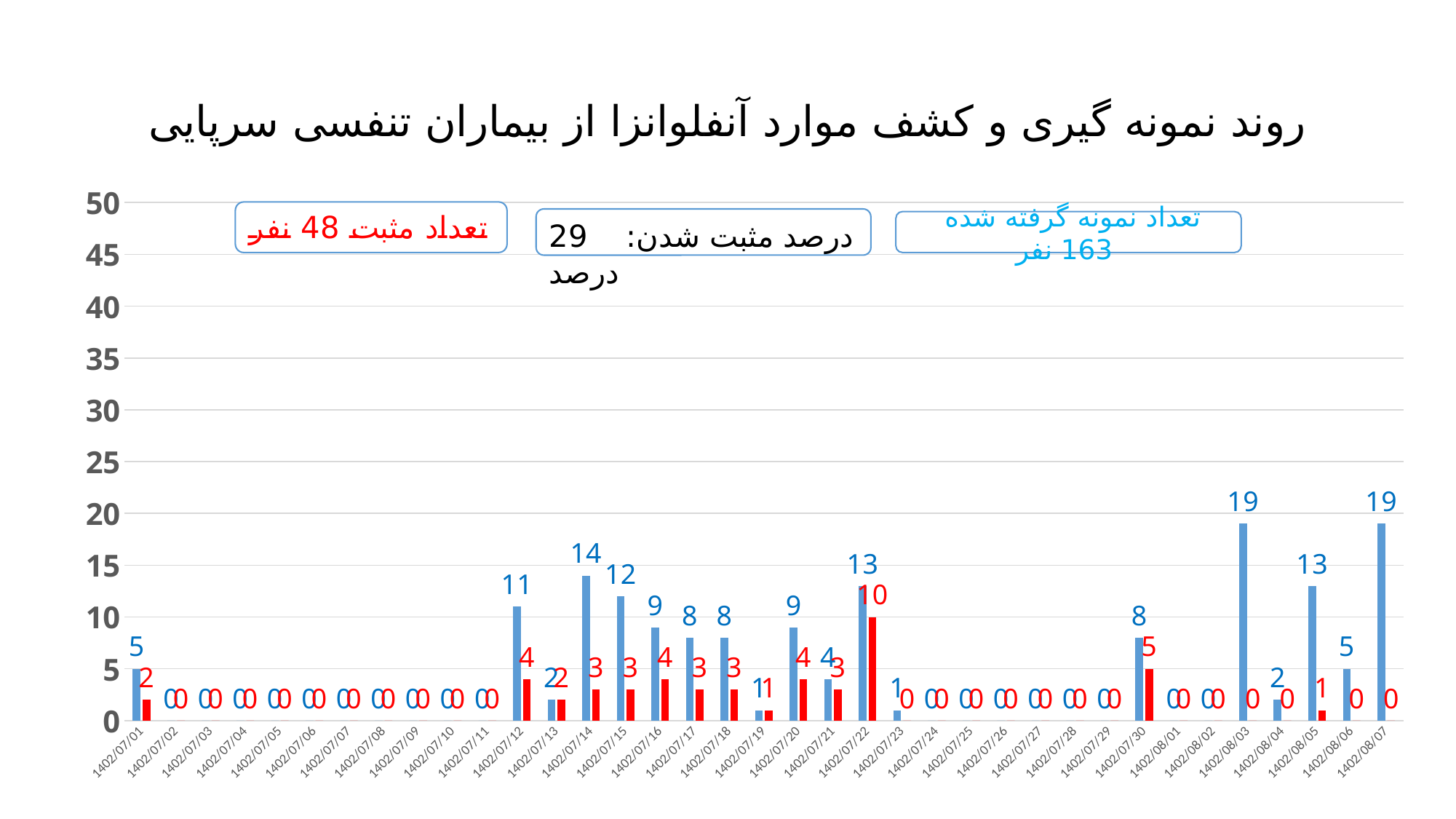
What is the value of the red bar for 1402/07/22? 10 Is the blue bar for 1402/08/03 greater or less than 15? greater What is the difference between the blue bar values for 1402/08/03 and 1402/08/05? 6 What is the value of the blue bar for 1402/07/12? 11 On which date does the red bar reach its highest value? 1402/07/22 What is the difference between the blue bar and the red bar on 1402/07/14? 11 Which date has the larger blue bar, 1402/07/15 or 1402/07/16? 1402/07/15 What is the value of the blue bar for 1402/07/30? 8 What is the highest value shown for the blue bars? 19 What is the title of the chart? روند نمونه گیری و کشف موارد آنفلوانزا از بیماران تنفسی سرپایی How many dates are shown on the x axis? 37 What kind of chart is shown on the slide? bar chart